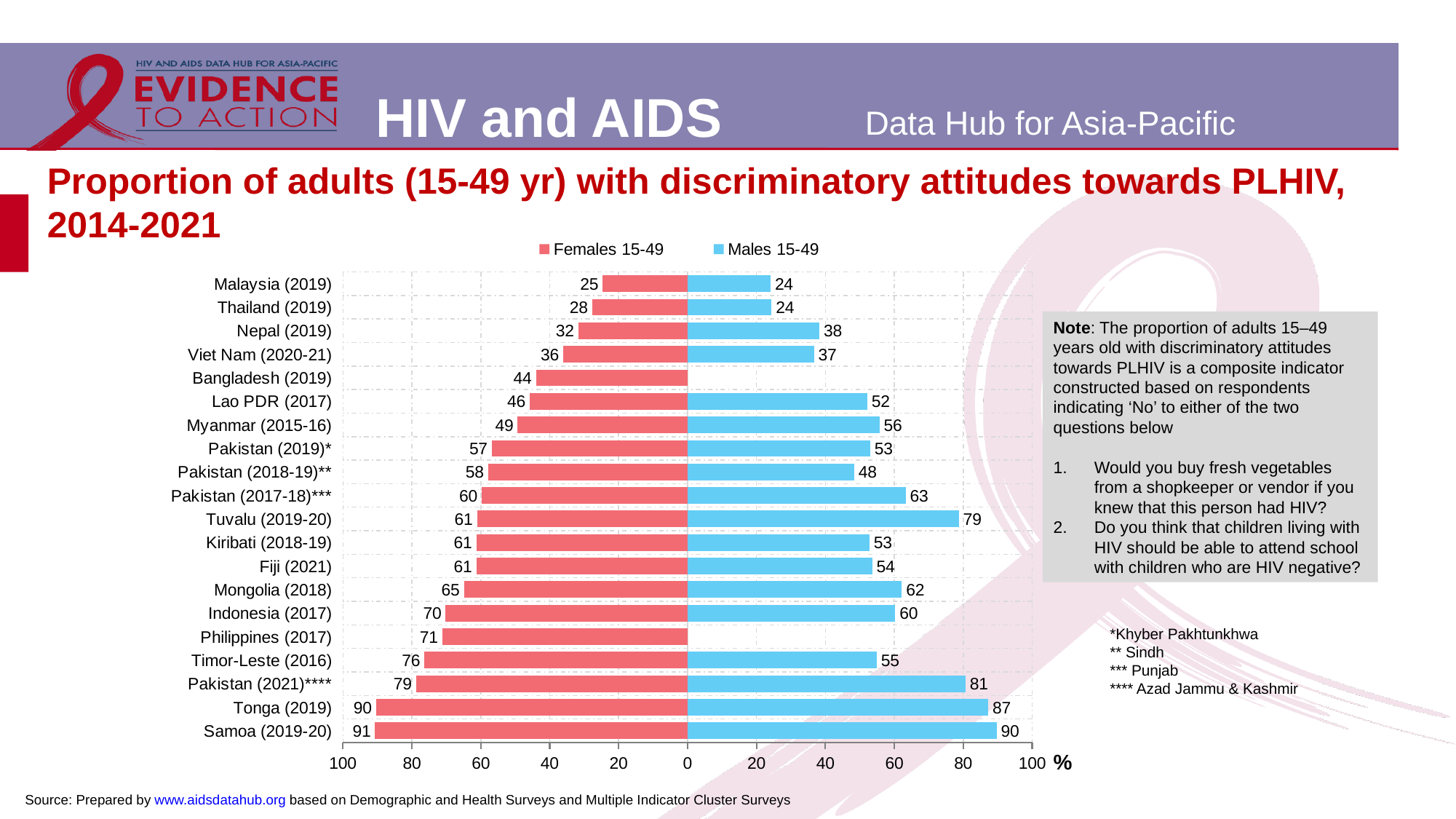
What kind of chart is shown on the slide? Bar chart Which country has the highest value for Females 15-49? Samoa (2019-20) How many countries/surveys are listed on the chart? 20 Which country has the lowest value for Females 15-49? Malaysia (2019) What is the value for Females 15-49 in Samoa (2019-20)? 91 What is the value for Males 15-49 in Tuvalu (2019-20)? 79 What is the difference between the Females 15-49 and Males 15-49 values for Tuvalu (2019-20)? 18 What is the value for Males 15-49 in Thailand (2019)? 24 What is the value for Females 15-49 in Philippines (2017)? 71 Which is larger for Indonesia (2017): the Females 15-49 value or the Males 15-49 value? Females 15-49 How many series does the legend list? 2 What colour represents Males 15-49 in the chart? Blue